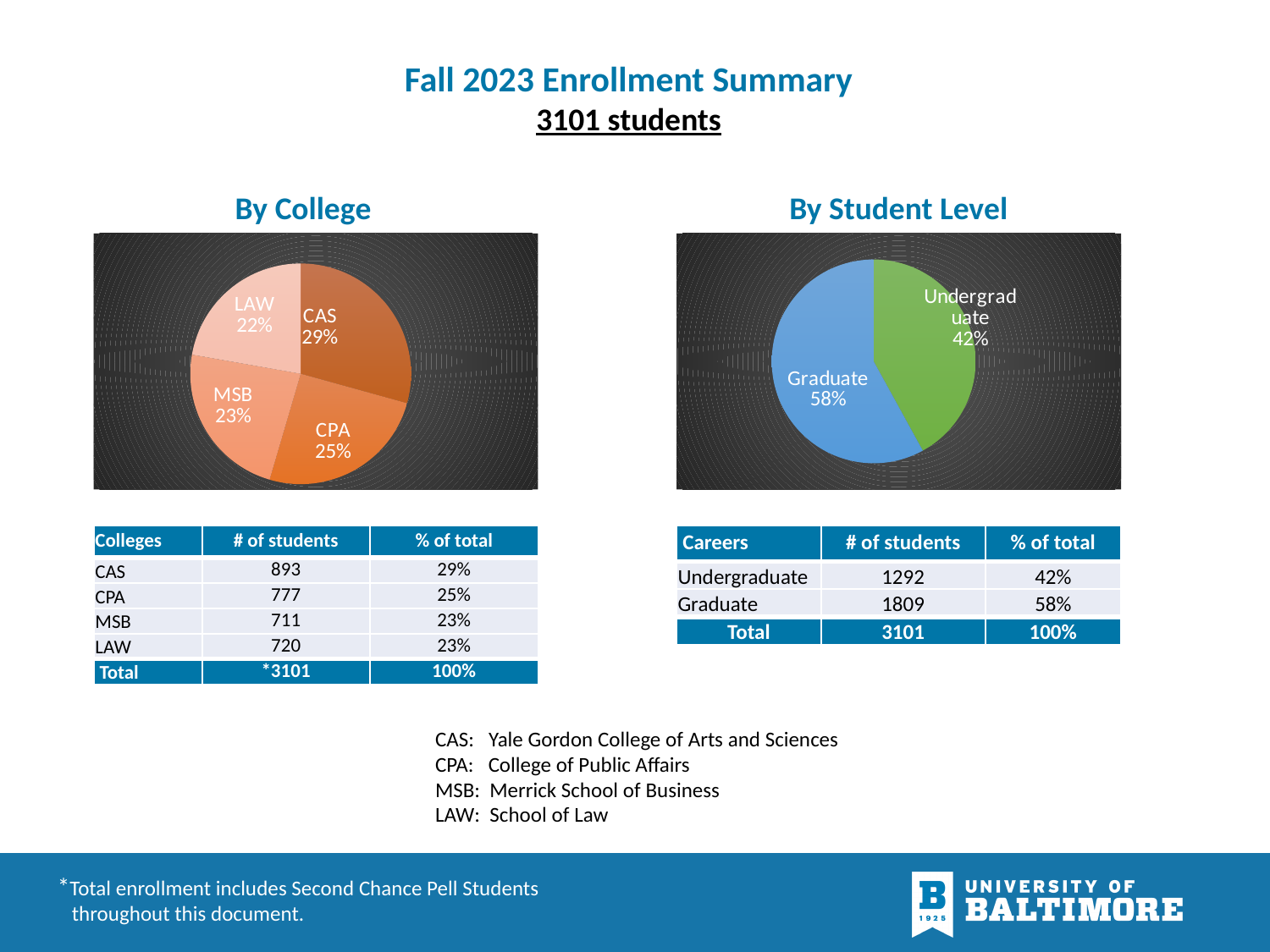
In the By Student Level chart, what share of students is Graduate? 58% In the By Student Level chart, what percentage is shown for Undergraduate? 42% In the By Student Level chart, what colour is the Graduate slice? Blue In the By College chart, what is the difference in percentage points between CAS and CPA? 4 In the By College chart, which college has the smallest slice? LAW In the By College chart, how many slices does the pie have? 4 In the By College chart, what percentage is shown for CPA? 25% In the By College chart, which college has the largest slice? CAS In the By College chart, what percentage is shown for MSB? 23% In the By Student Level chart, which is larger, Graduate or Undergraduate? Graduate In the By College chart, what share of students is in CAS? 29% What kind of chart is the By Student Level chart? Pie chart